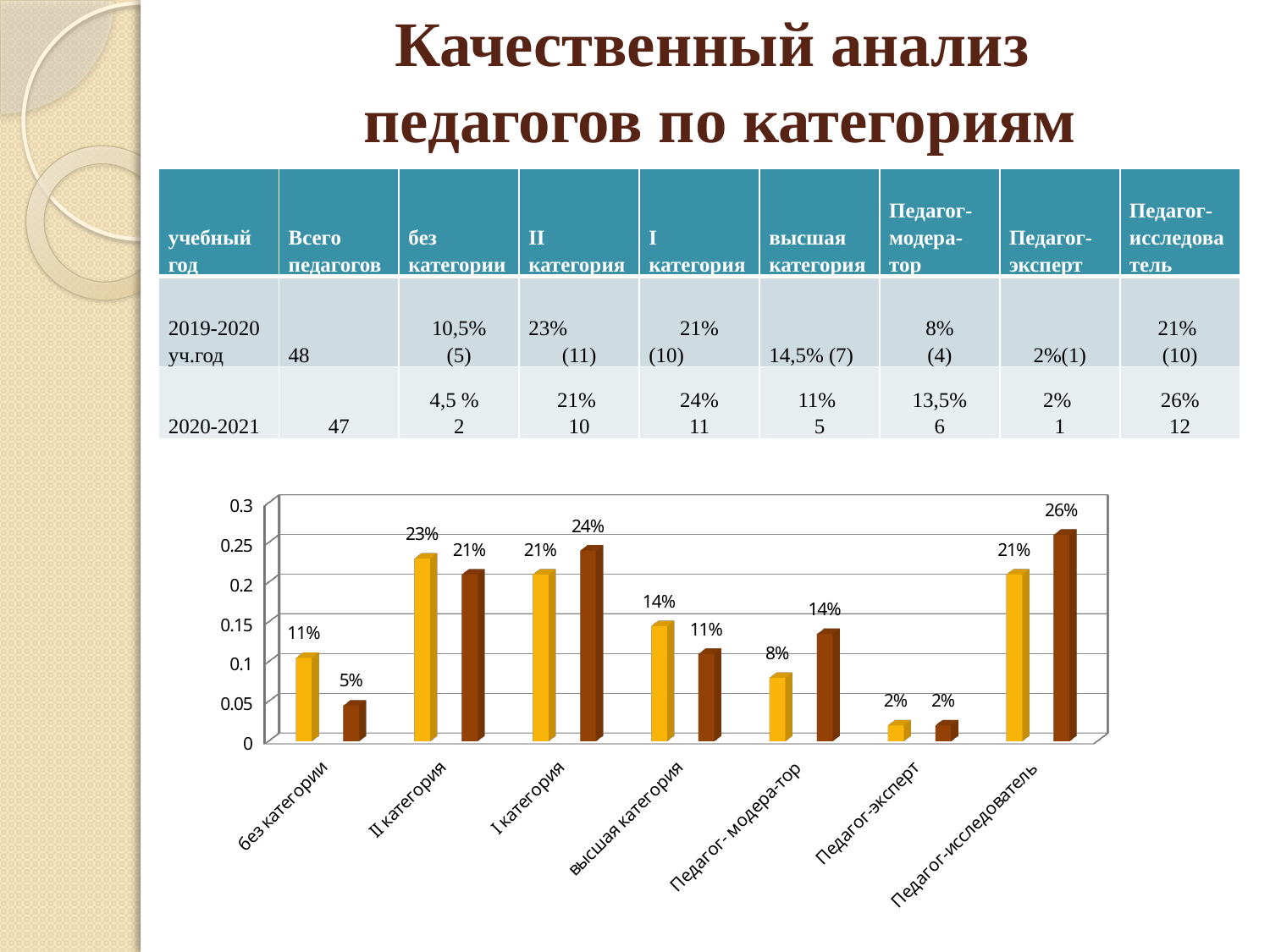
Which category has the lowest yellow bar? Педагог-эксперт What is the difference between the brown bar for 'Педагог-исследователь' and the brown bar for 'Педагог-эксперт'? 24% What is the value of the yellow bar for 'без категории'? 11% What is the value of the brown bar for 'Педагог- модера-тор'? 14% What is the difference between the yellow and brown bars for 'без категории'? 6% Which is larger for 'I категория': the yellow bar or the brown bar? the brown bar What kind of chart is shown on the slide? bar chart How many categories are shown on the x axis of the chart? 7 Which category has the highest brown bar? Педагог-исследователь What is the value of the brown bar for 'Педагог-исследователь'? 26% Is the value of the yellow bar for 'II категория' greater or less than 0.2? greater What is the highest tick value shown on the vertical axis of the chart? 0.3